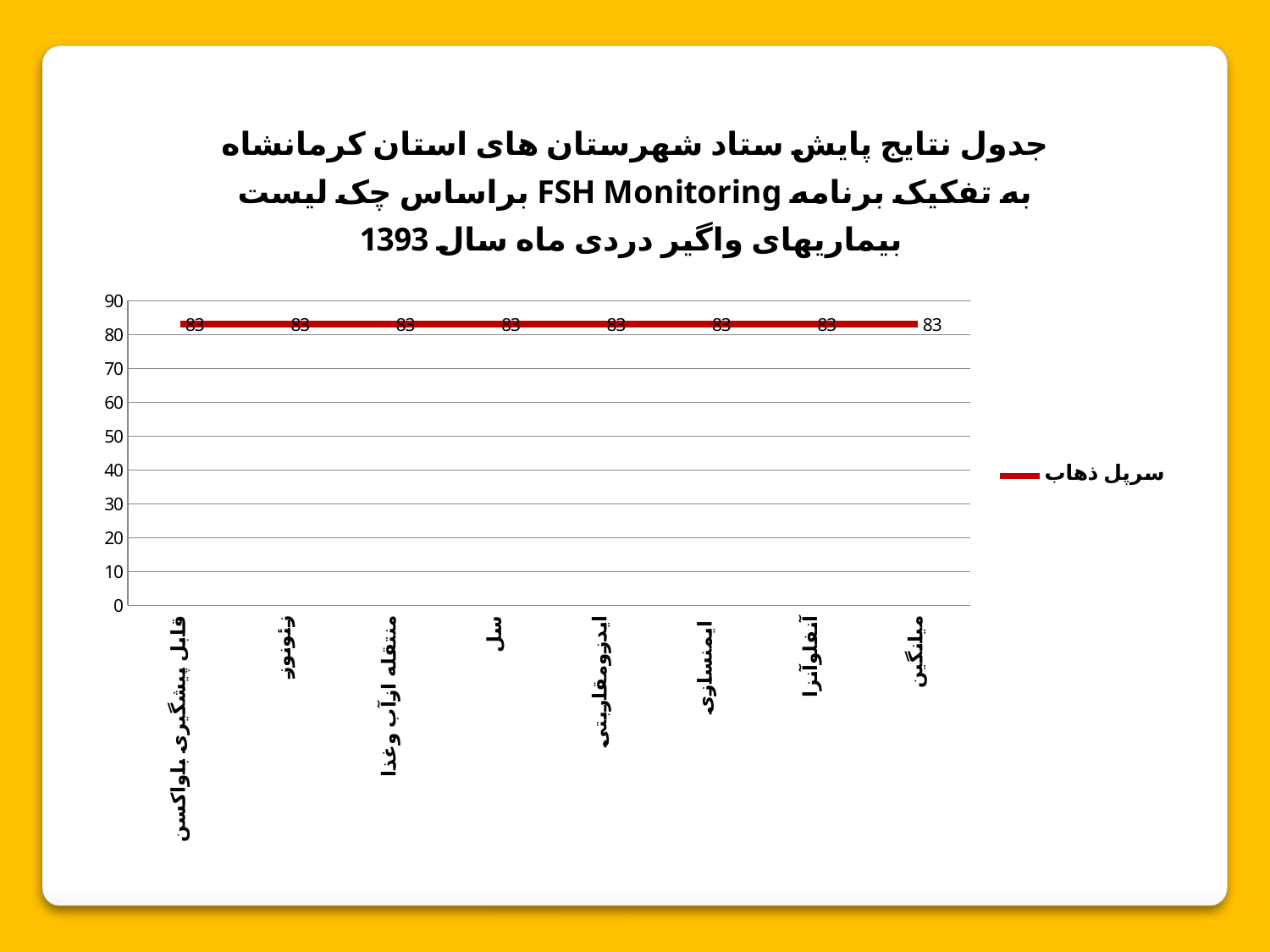
What is the difference between the values for زئونوز and سل? 0 What is the value for میانگین? 83 Do the values rise, fall, or stay flat across the categories? Stay flat What is the name of the series shown in the legend? سرپل ذهاب What is the value for ایمنسازی? 83 How many categories are shown on the x axis? 8 Is the value for قابل پیشگیری با واکسن greater or less than 90? less What kind of chart is shown on the slide? Line chart What is the value for سل? 83 How many series does the legend list? 1 Is the value for ایدز و مقاربتی greater or less than 70? greater What is the value for آنفلوآنزا? 83